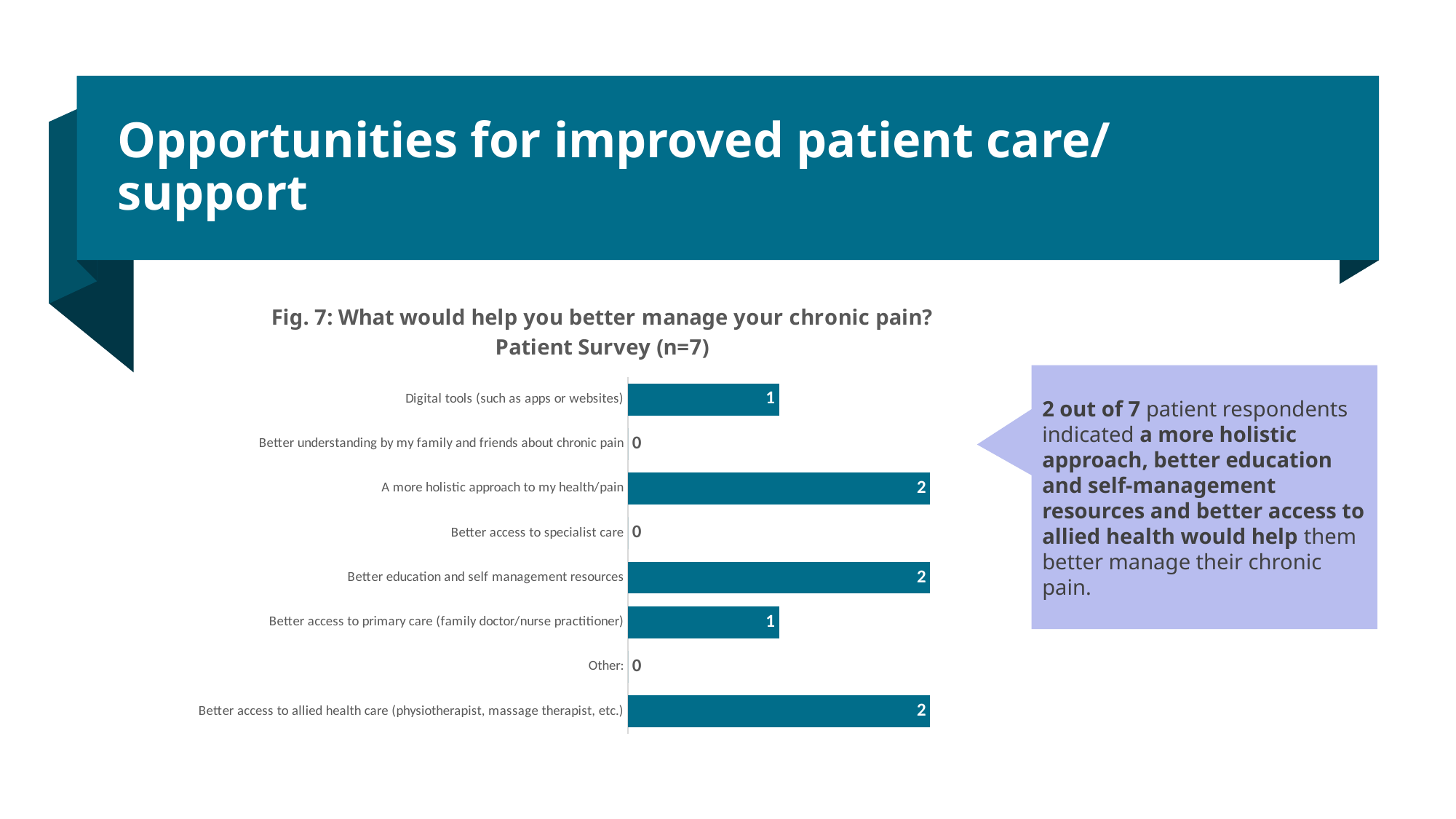
What kind of chart is shown on the slide? Bar chart How many categories are shown in the chart? 8 What is the value for "A more holistic approach to my health/pain"? 2 How many categories have a value of 2? 3 Which is larger, the value for "Digital tools (such as apps or websites)" or the value for "Better education and self management resources"? Better education and self management resources What is the difference between the value for "Better access to allied health care (physiotherapist, massage therapist, etc.)" and the value for "Better access to primary care (family doctor/nurse practitioner)"? 1 What is the value for "Better access to primary care (family doctor/nurse practitioner)"? 1 What is the value for "Better access to specialist care"? 0 What is the value for "Digital tools (such as apps or websites)"? 1 What is the value for "Other:"? 0 How many categories have a value of 0? 3 What is the title of the chart? Fig. 7: What would help you better manage your chronic pain? Patient Survey (n=7)